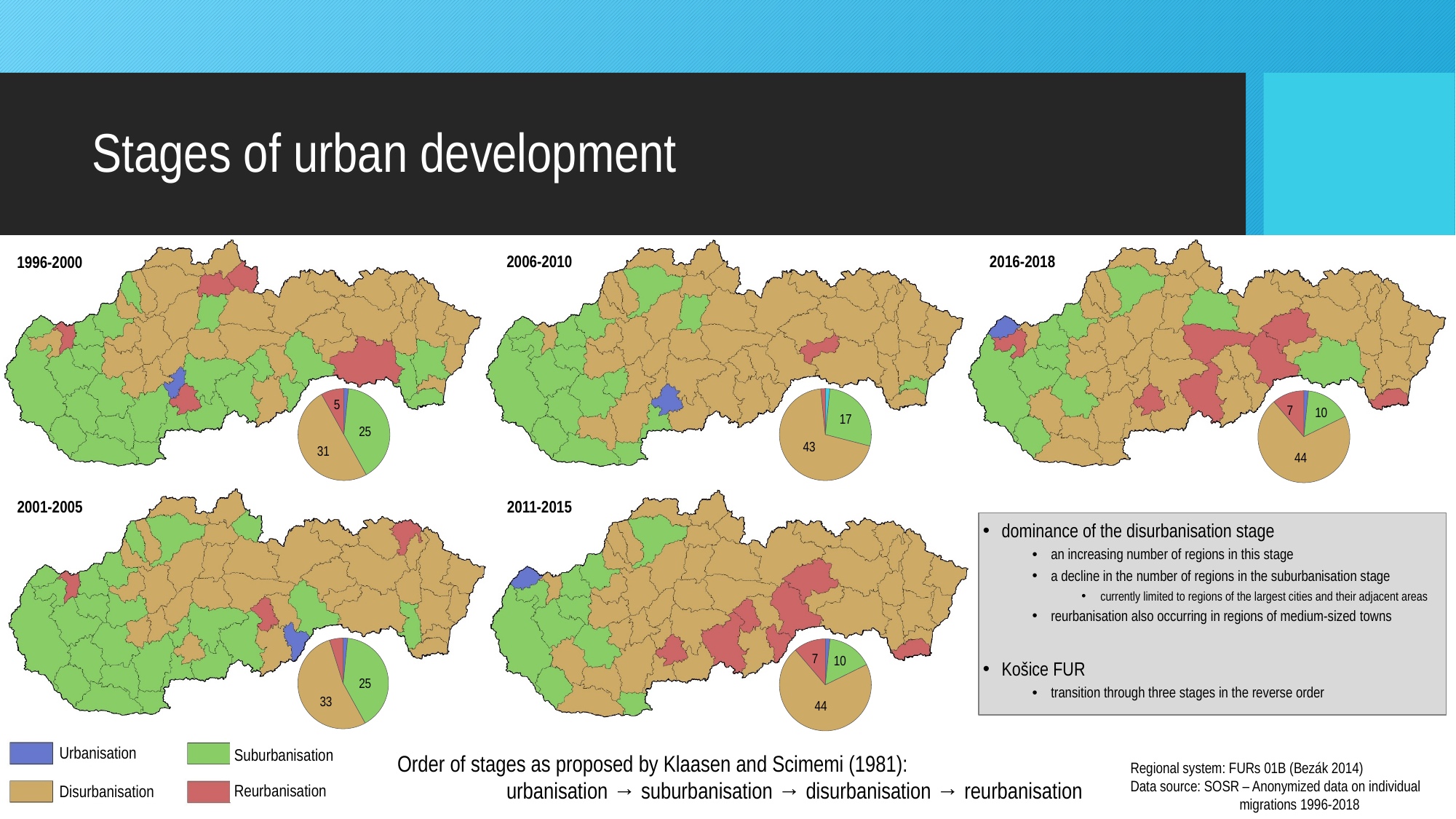
In the pie chart for 2011-2015, which stage has the largest slice? Disurbanisation Across the periods from 1996-2000 to 2016-2018, does the disurbanisation value in the pie charts rise or fall? Rise In the pie chart for 1996-2000, what is the value for the reurbanisation slice? 5 In the pie chart for 2001-2005, what is the value for the disurbanisation slice? 33 What kind of chart is used to summarise the stages for each period? Pie chart In the pie chart for 1996-2000, what is the value for the suburbanisation slice? 25 In the pie chart for 2006-2010, what is the difference between the disurbanisation and suburbanisation values? 26 In the pie chart for 2006-2010, what is the value for the suburbanisation slice? 17 In the pie chart for 2016-2018, what is the value for the disurbanisation slice? 44 According to the legend, which colour represents urbanisation? Blue In the pie chart for 2016-2018, which is larger, the suburbanisation slice or the reurbanisation slice? Suburbanisation In the pie chart for 1996-2000, what is the value for the disurbanisation slice? 31